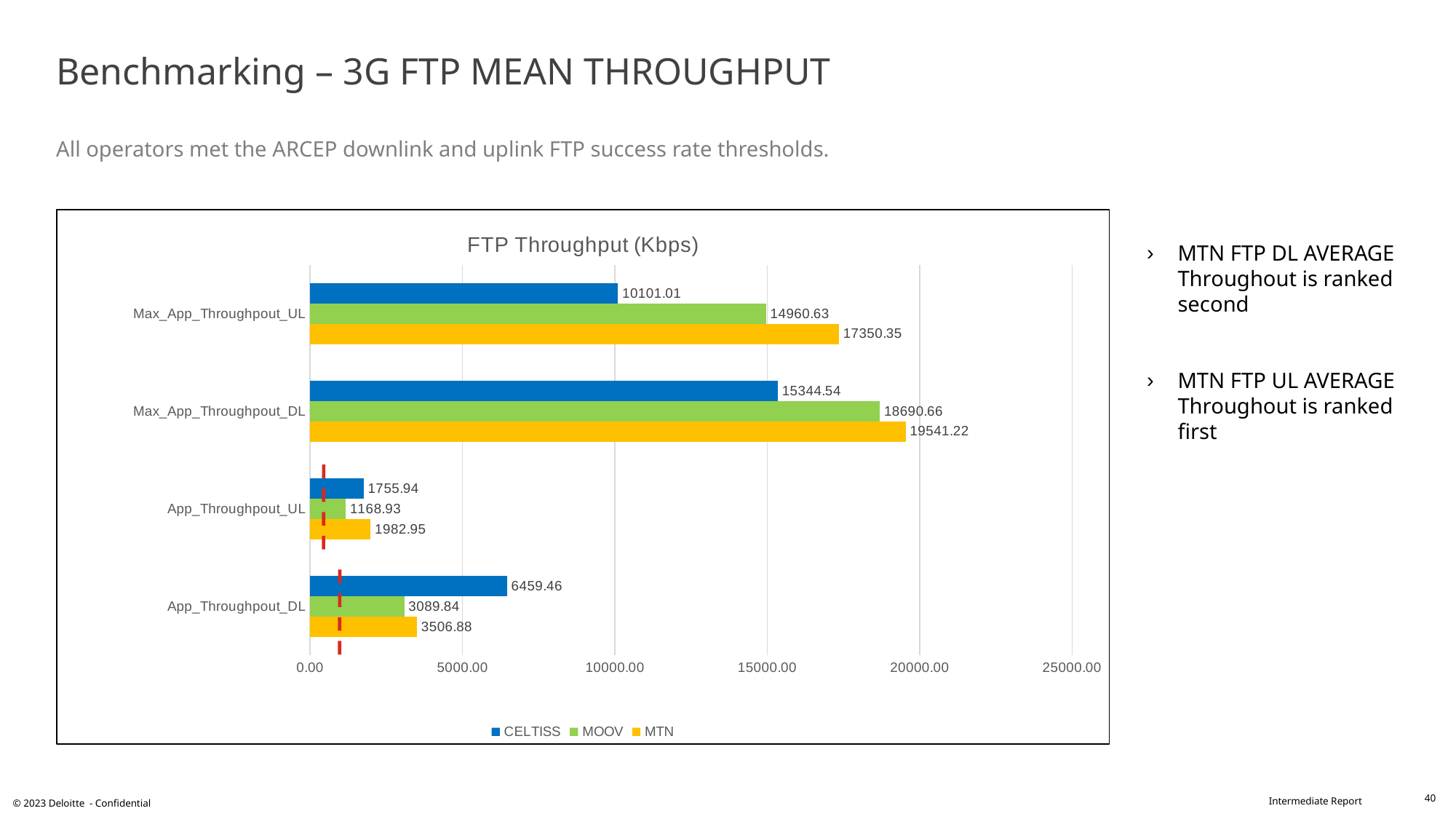
What is the MOOV value for App_Throughpout_UL? 1168.93 Which operator has the lowest value for App_Throughpout_DL? MOOV What is the difference between the MTN and CELTISS values for Max_App_Throughpout_DL? 4196.68 What type of chart is shown on the slide? Bar chart For App_Throughpout_UL, which is larger: the CELTISS value or the MTN value? MTN Which operator has the highest value for Max_App_Throughpout_UL? MTN What is the CELTISS value for App_Throughpout_DL? 6459.46 How many categories are shown on the chart? 4 Is the MOOV value for Max_App_Throughpout_DL greater or less than 15000.00? greater What is the CELTISS value for Max_App_Throughpout_UL? 10101.01 What is the MTN value for Max_App_Throughpout_DL? 19541.22 How many series does the legend list? 3